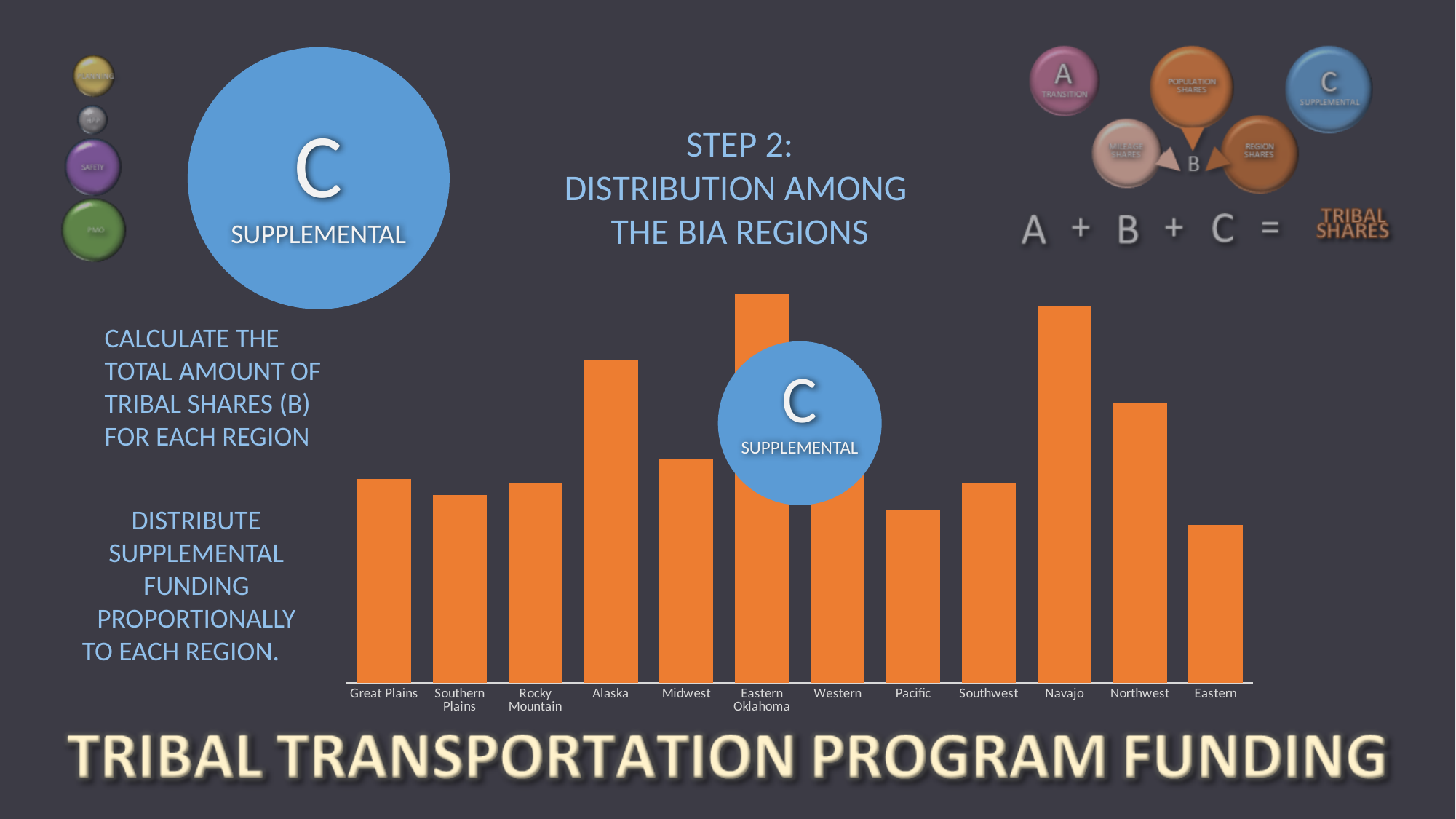
Which bar is taller, Southwest or Northwest? Northwest Which bar is taller, Alaska or Midwest? Alaska Which region has the shortest bar in the chart? Eastern What kind of chart is shown on the slide? bar chart Which bar is taller, Great Plains or Eastern? Great Plains What is the label of the first category on the left of the x axis? Great Plains Which region has the tallest bar in the chart? Eastern Oklahoma What colour are the bars in the chart? orange How many regions are shown along the x axis of the chart? 12